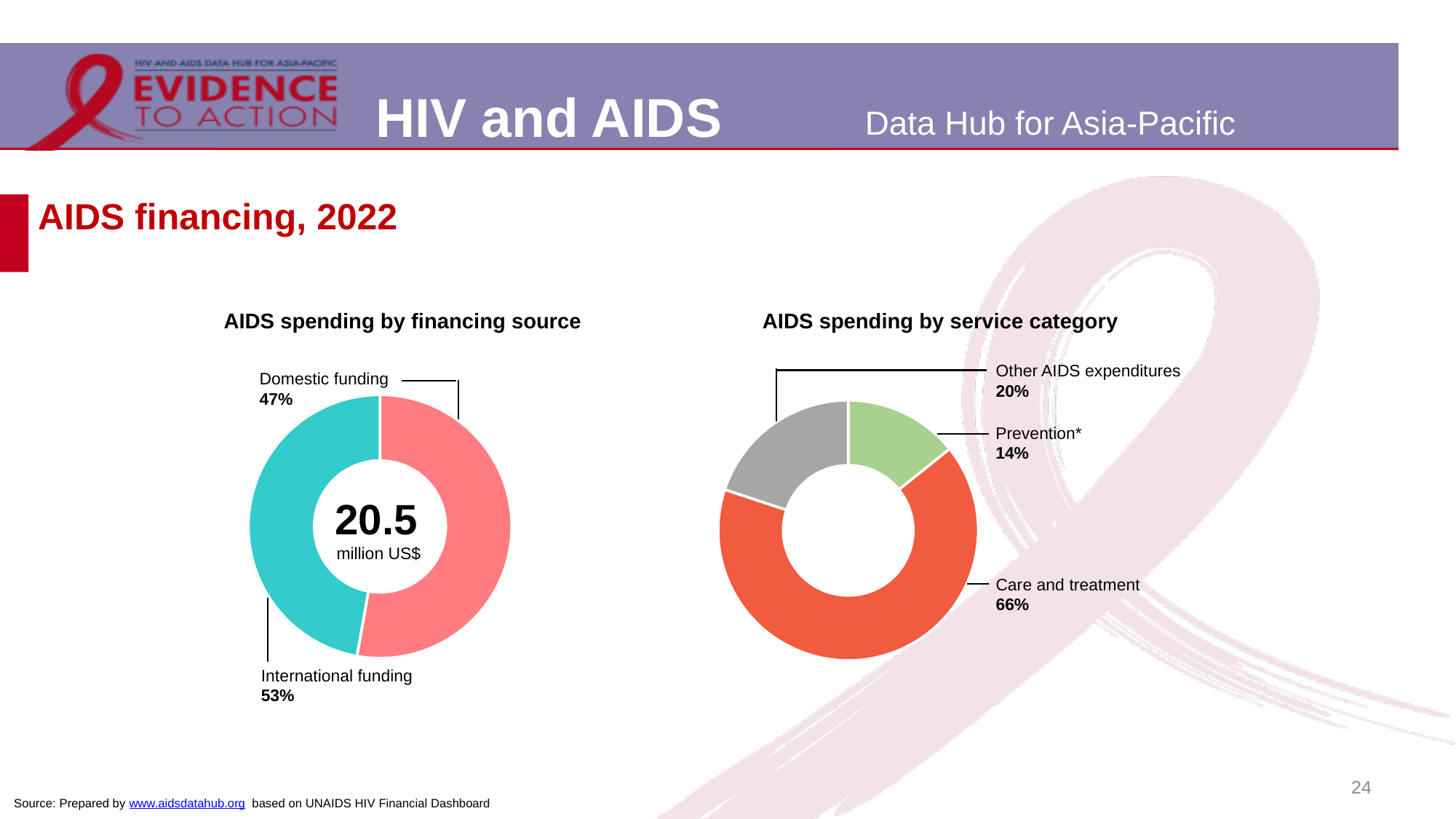
In the 'AIDS spending by financing source' chart, what share is International funding? 53% In the 'AIDS spending by financing source' chart, which financing source has the larger share? International funding In the 'AIDS spending by financing source' chart, what share is Domestic funding? 47% In the 'AIDS spending by service category' chart, what share is Prevention*? 14% In the 'AIDS spending by service category' chart, which service category has the smallest share? Prevention* In the 'AIDS spending by financing source' chart, what is the difference in percentage points between International funding and Domestic funding? 6 percentage points In the 'AIDS spending by financing source' chart, what total amount is shown in the centre of the donut? 20.5 million US$ How many categories are shown in the 'AIDS spending by service category' chart? 3 What type of chart is used for 'AIDS spending by financing source'? Donut (pie) chart In the 'AIDS spending by service category' chart, what share is Care and treatment? 66% In the 'AIDS spending by service category' chart, what share is Other AIDS expenditures? 20% In the 'AIDS spending by service category' chart, which service category has the largest share? Care and treatment